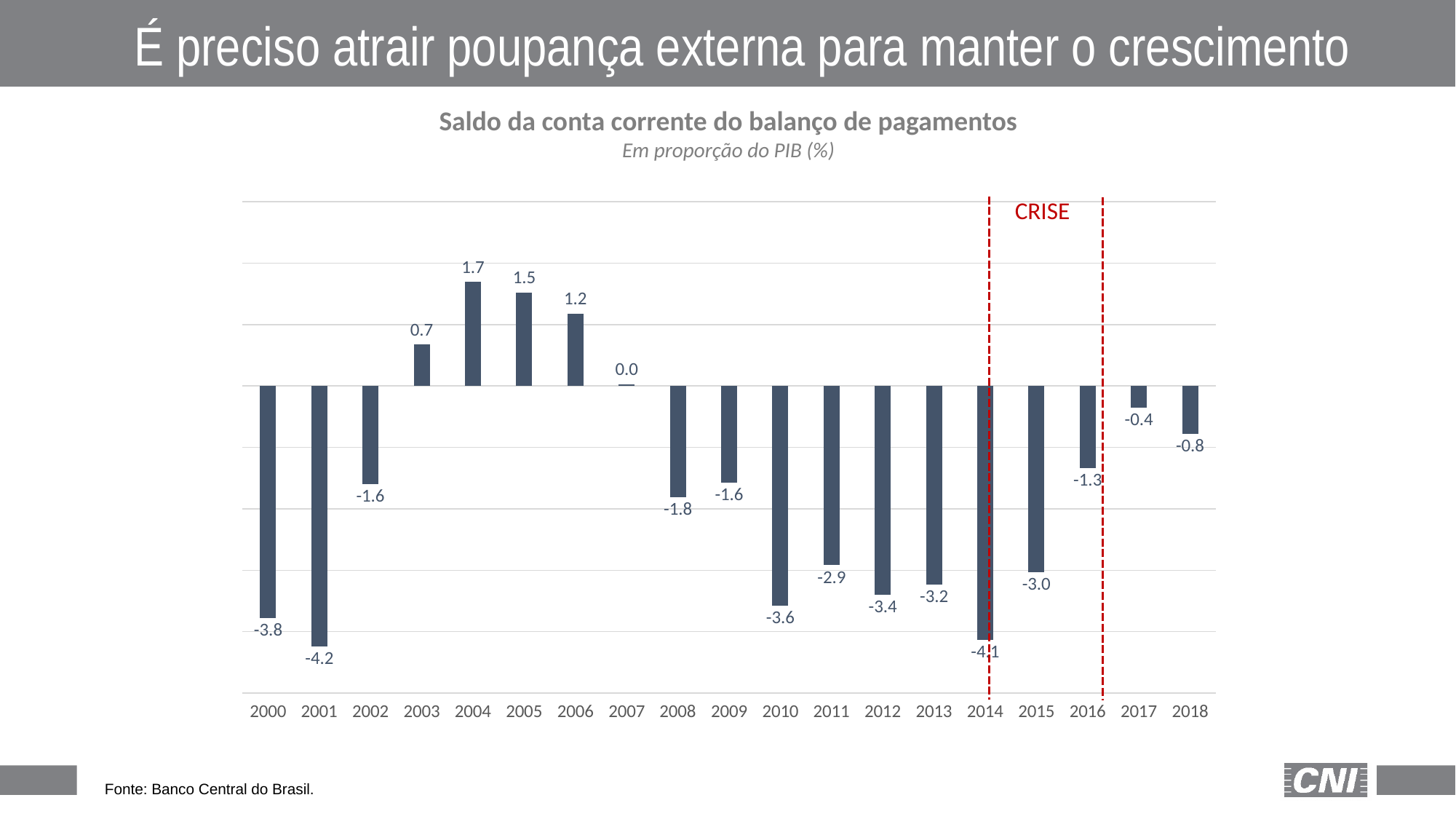
How many years are shown on the x axis? 19 What is the difference between the values for 2004 and 2005? 0.2 Which is larger, the value for 2010 or the value for 2011? 2011 What is the title of the chart? Saldo da conta corrente do balanço de pagamentos What kind of chart is this? Bar chart What is the value for 2018? -0.8 What is the value for 2014? -4.1 Which year has the lowest value? 2001 Which year has the highest value? 2004 What is the difference between the values for 2001 and 2014? 0.1 What is the value for 2007? 0.0 What is the value for 2004? 1.7